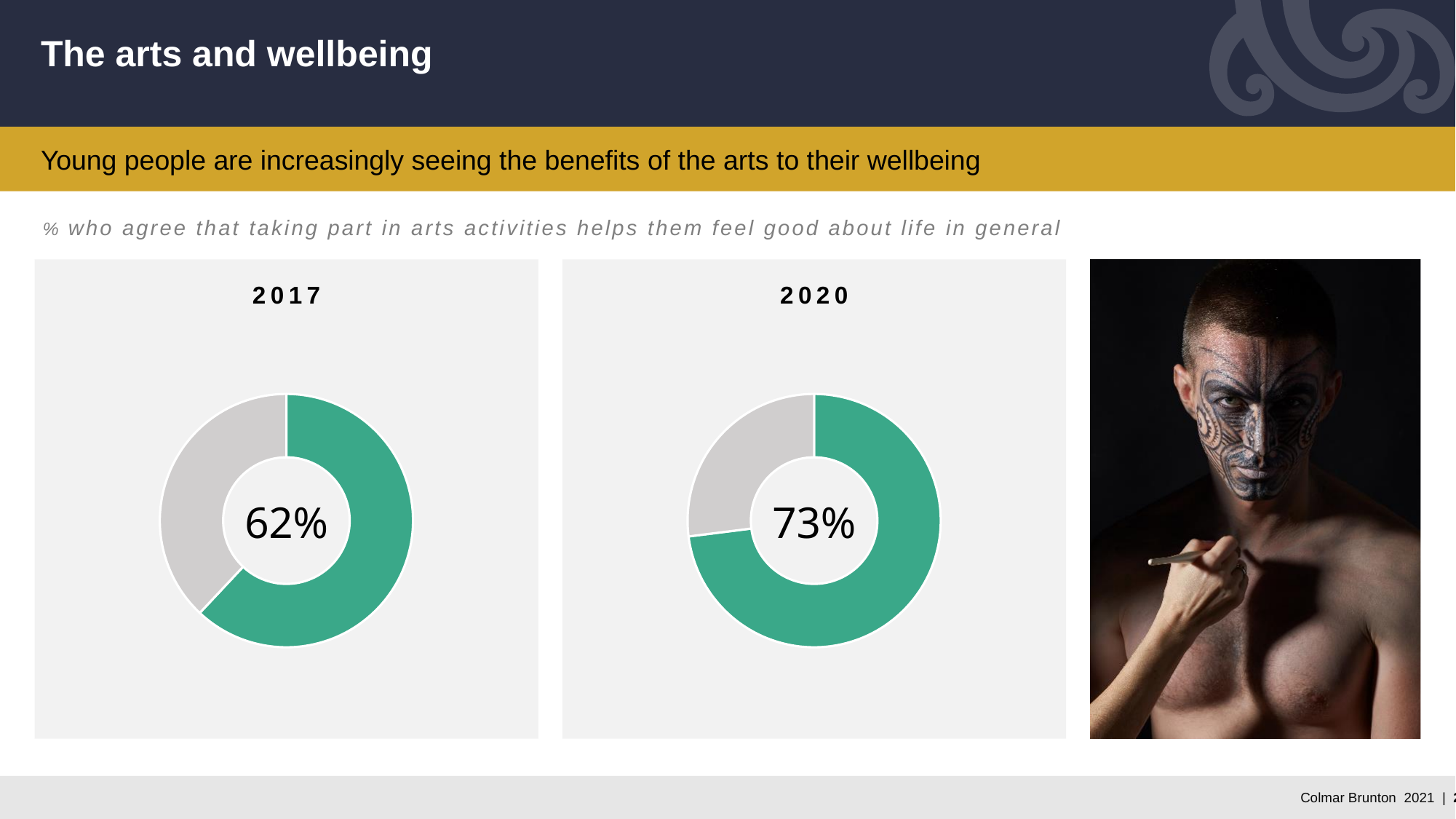
Did the percentage agreeing rise or fall from 2017 to 2020? Rise In the 2020 chart, is the value greater or less than 75%? less Which year shows the higher percentage agreeing, 2017 or 2020? 2020 What is the title of the chart on the left? 2017 In the 2017 chart, what percentage of young people agree that taking part in arts activities helps them feel good about life in general? 62% In the 2017 chart, is the value greater or less than 50%? greater By how many percentage points did the share agreeing increase from the 2017 chart to the 2020 chart? 11 percentage points Which year shows the lower percentage agreeing, 2017 or 2020? 2017 In the 2020 chart, what percentage of young people agree that taking part in arts activities helps them feel good about life in general? 73% How many doughnut charts are shown on the slide? 2 What colour is used for the segment representing the percentage who agree in both charts? Green What kind of chart is used to show the 2017 value? Doughnut chart